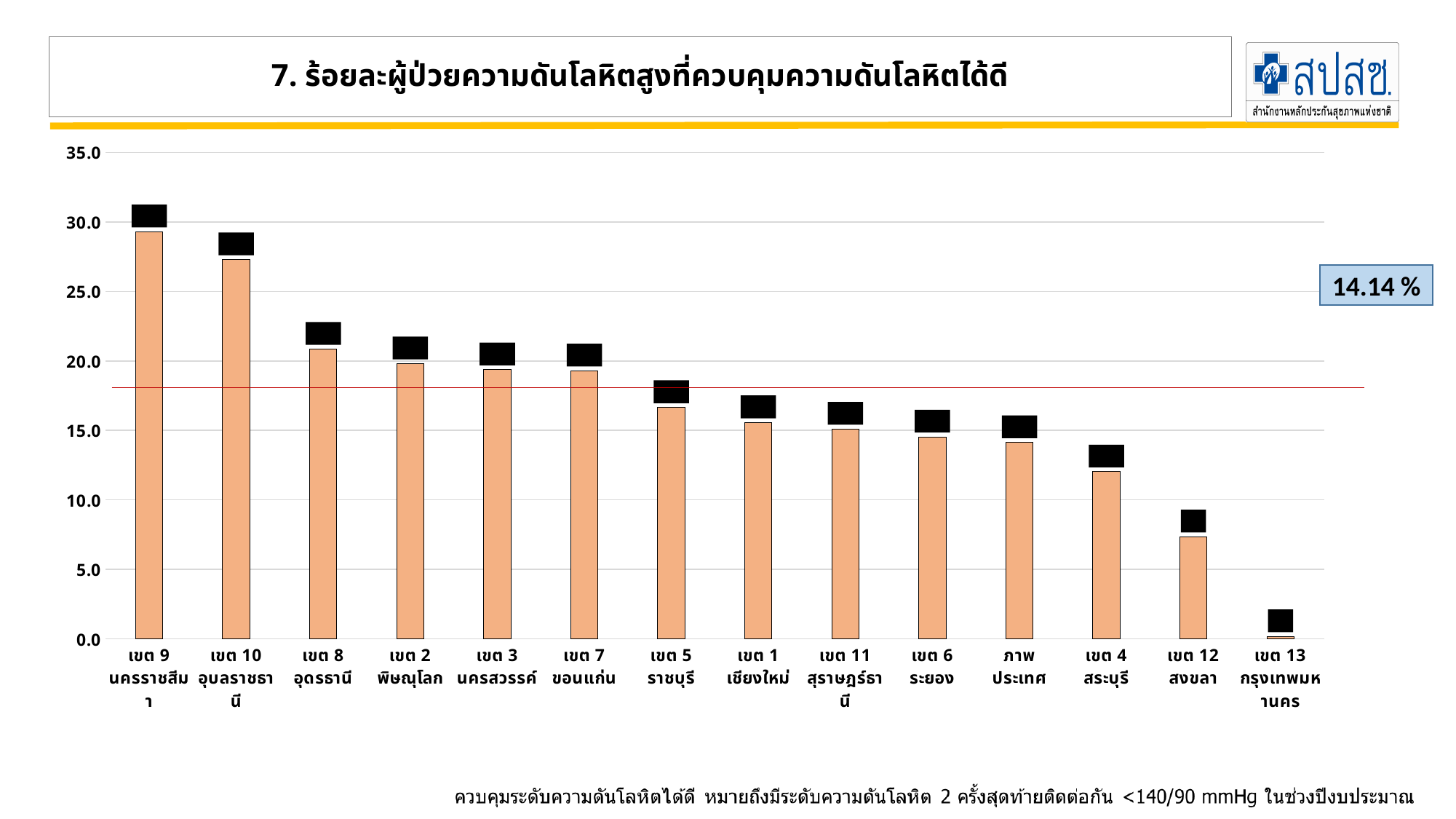
Which is larger, the value for เขต 10 อุบลราชธานี or the value for เขต 2 พิษณุโลก? เขต 10 อุบลราชธานี Is the value for เขต 12 สงขลา greater or less than 10.0? less Which is larger, the value for ภาพประเทศ or the value for เขต 5 ราชบุรี? เขต 5 ราชบุรี Is the value for เขต 8 อุดรธานี greater or less than 20.0? greater Do the bar values rise or fall from left to right along the x axis? fall What kind of chart is shown on the slide? bar chart Which category has the lowest bar in the chart? เขต 13 กรุงเทพมหานคร What is the title of the chart? 7. ร้อยละผู้ป่วยความดันโลหิตสูงที่ควบคุมความดันโลหิตได้ดี Is the value for เขต 9 นครราชสีมา greater or less than 25.0? greater How many categories (bars) are plotted in the chart? 14 Which category has the highest bar in the chart? เขต 9 นครราชสีมา